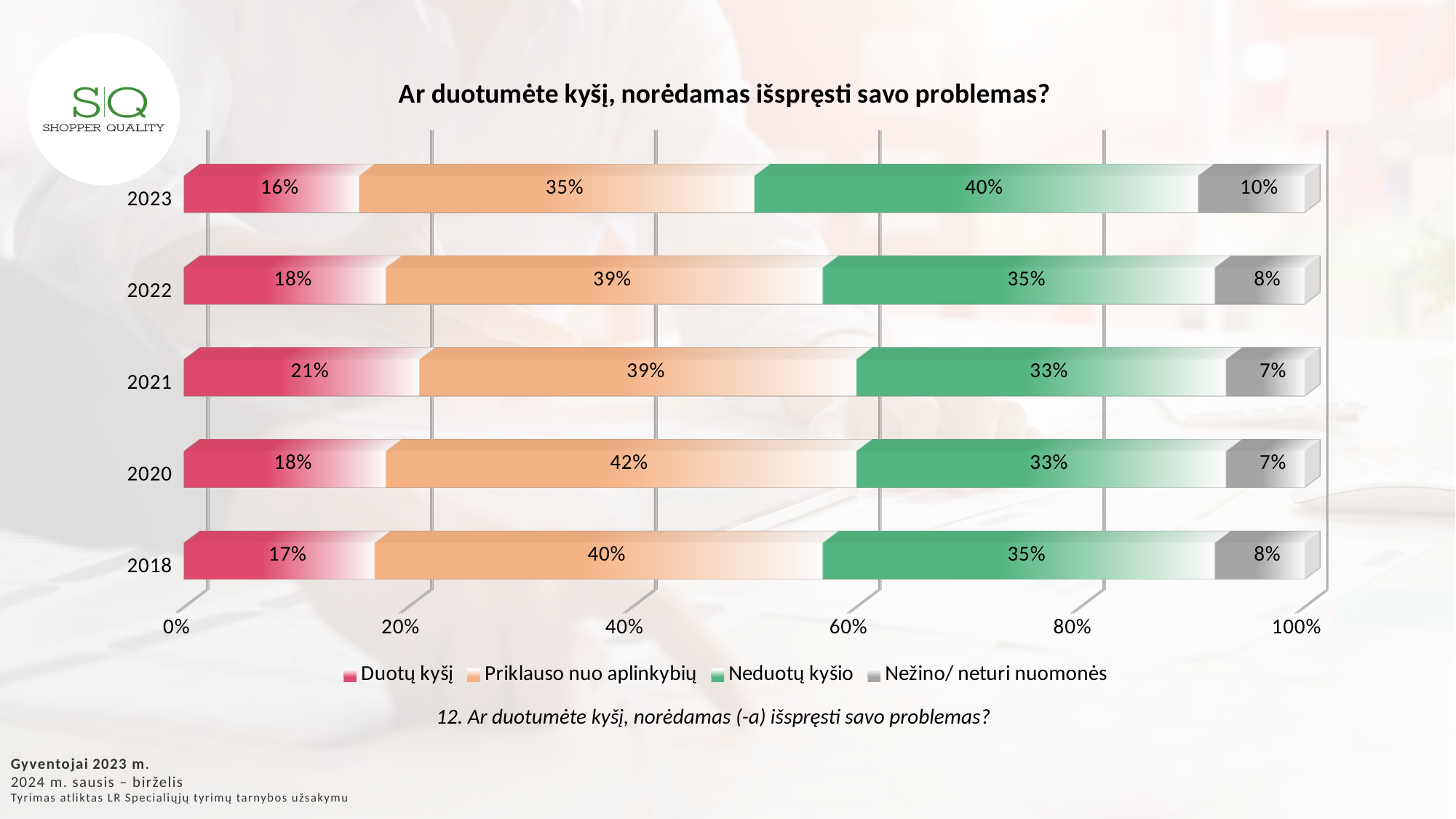
What is the value for "Duotų kyšį" in 2023? 16% In which year is the "Duotų kyšį" value highest? 2021 What is the value for "Neduotų kyšio" in 2018? 35% What is the value for "Nežino/ neturi nuomonės" in 2021? 7% What is the difference between the "Neduotų kyšio" values for 2023 and 2022? 5% What is the value for "Priklauso nuo aplinkybių" in 2020? 42% What is the title of the chart? Ar duotumėte kyšį, norėdamas išspręsti savo problemas? How many series does the legend list? 4 How many years are shown on the chart? 5 Which is larger: the "Priklauso nuo aplinkybių" value in 2020 or in 2023? 2020 In which year is the "Neduotų kyšio" value highest? 2023 What kind of chart is shown on the slide? Stacked bar chart